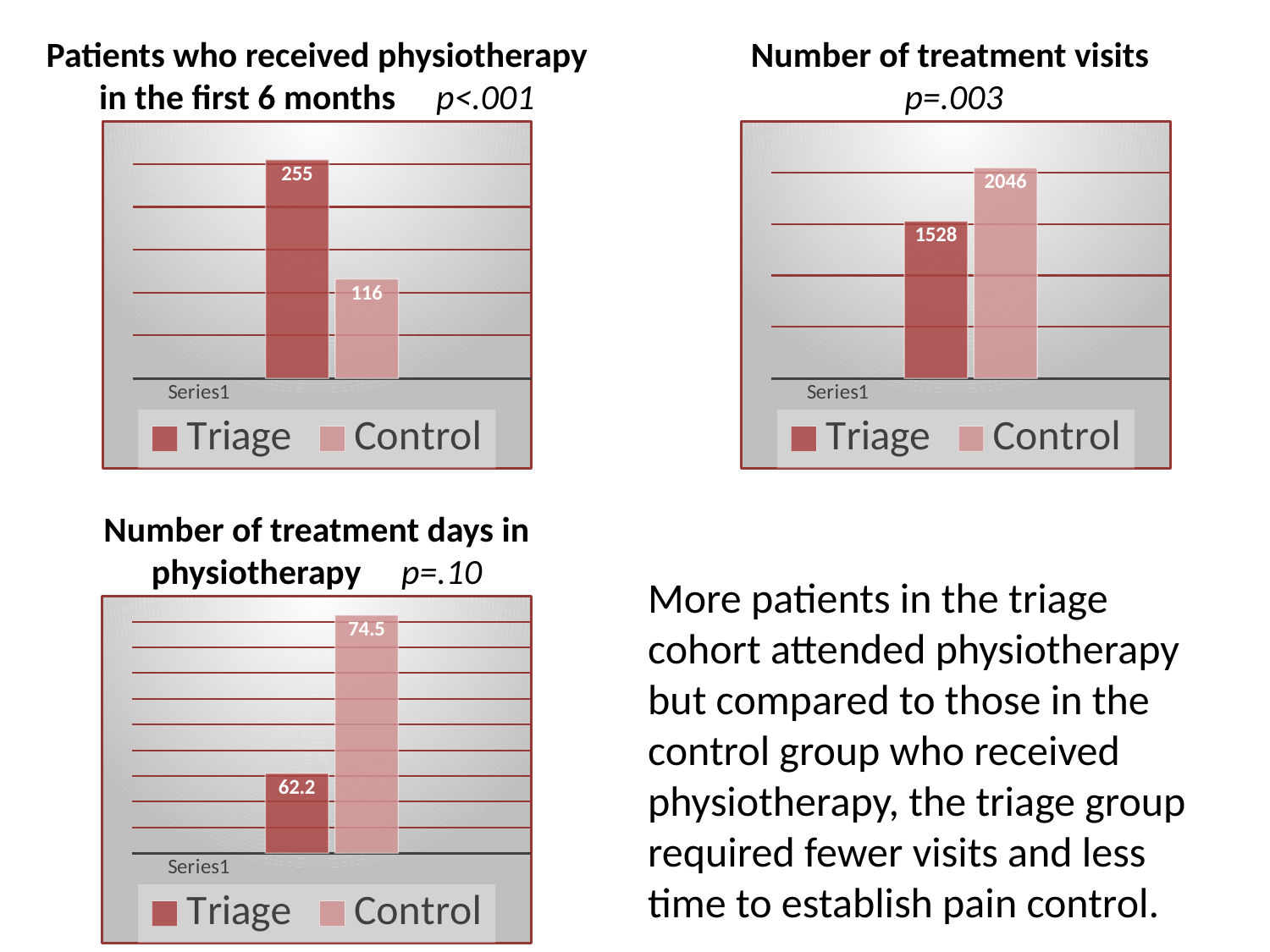
In the 'Number of treatment visits' chart, which group has the higher value? Control In the 'Number of treatment days in physiotherapy' chart, what is the value for Triage? 62.2 In the 'Number of treatment visits' chart, what is the value for Control? 2046 In the 'Patients who received physiotherapy in the first 6 months' chart, what is the value for Control? 116 In the 'Patients who received physiotherapy in the first 6 months' chart, what is the value for Triage? 255 In the 'Number of treatment days in physiotherapy' chart, what is the value for Control? 74.5 In the 'Number of treatment visits' chart, what is the value for Triage? 1528 In the 'Patients who received physiotherapy in the first 6 months' chart, what is the difference between the Triage and Control values? 139 In the 'Number of treatment visits' chart, what is the difference between the Control and Triage values? 518 In the 'Number of treatment days in physiotherapy' chart, which group has the lower value? Triage How many series does the legend of the 'Number of treatment visits' chart list? 2 What type of chart is the 'Number of treatment days in physiotherapy' chart? Bar chart